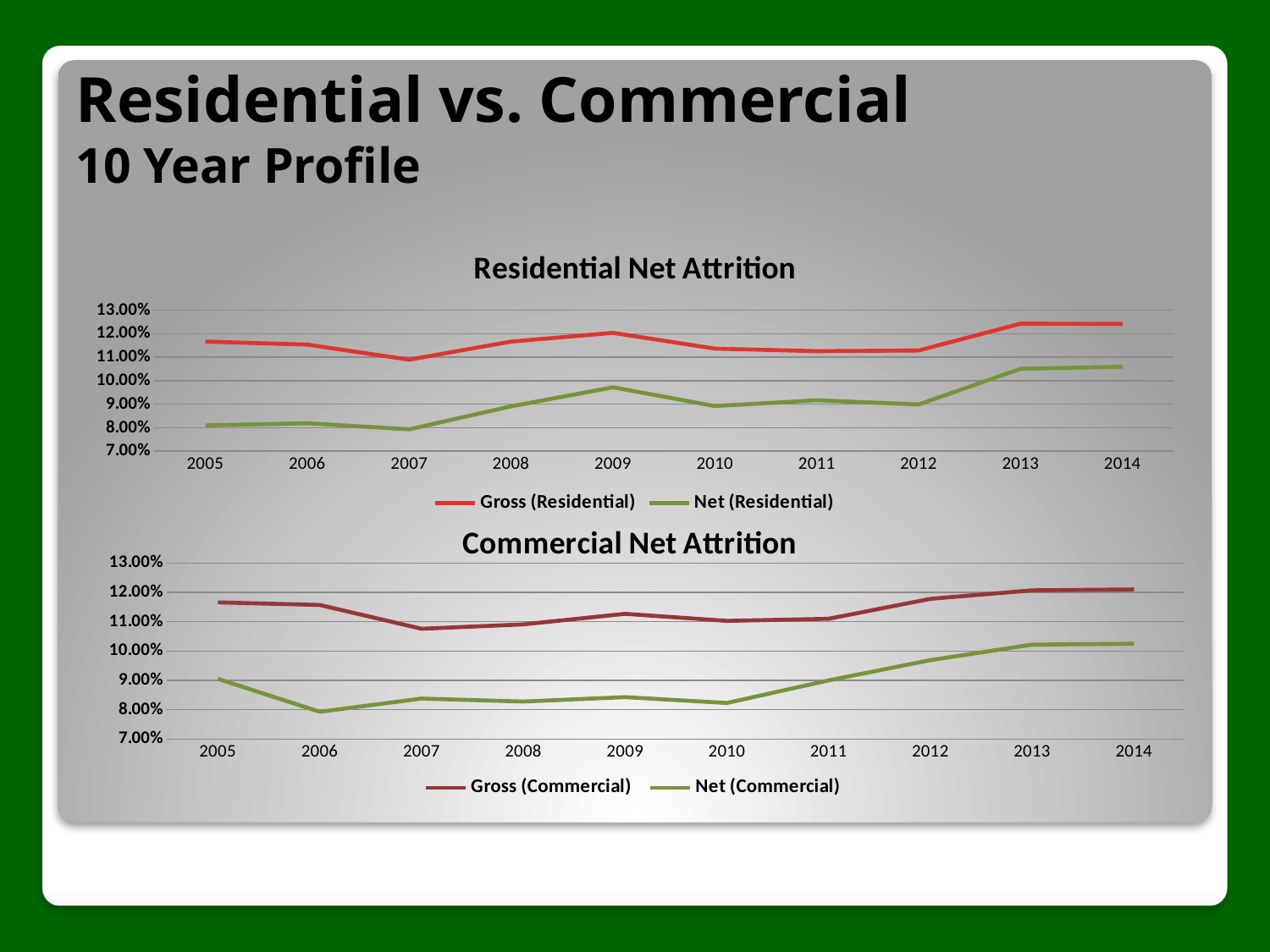
In the Residential Net Attrition chart, is the value for Gross (Residential) in 2013 greater or less than 12.00%? greater In the Residential Net Attrition chart, is the value for Net (Residential) in 2009 greater or less than 9.00%? greater In the Commercial Net Attrition chart, does the Net (Commercial) line rise or fall from 2010 to 2014? rise How many series does the legend of the Commercial Net Attrition chart list? 2 In the Commercial Net Attrition chart, which year has the lowest value for Net (Commercial)? 2006 In the Commercial Net Attrition chart, is the value for Net (Commercial) in 2014 greater or less than 10.00%? greater What type of chart is the Residential Net Attrition chart? line chart What colour is the Gross (Residential) line in the Residential Net Attrition chart? red In the Residential Net Attrition chart, which is larger in 2009: Gross (Residential) or Net (Residential)? Gross (Residential) How many years are plotted on the x axis of the Residential Net Attrition chart? 10 In the Residential Net Attrition chart, which year has the lowest value for Gross (Residential)? 2007